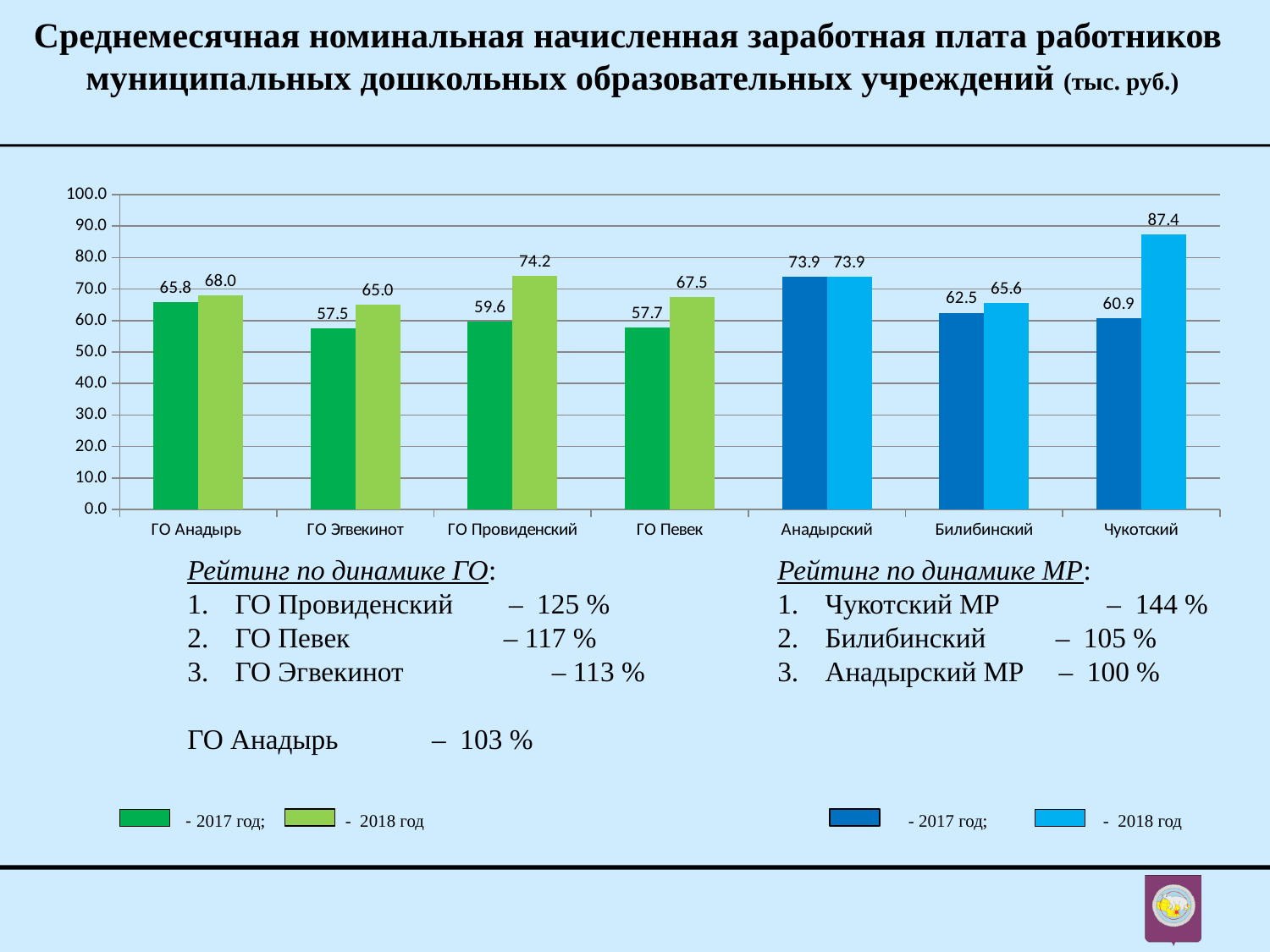
What was the 2017 value for ГО Провиденский? 59.6 What is the difference between the 2018 and 2017 values for Чукотский? 26.5 Which category has the lowest 2017 value? ГО Эгвекинот Which two years are compared in the chart legend? 2017 and 2018 What is the difference between the 2018 and 2017 values for ГО Провиденский? 14.6 What was the 2018 value for ГО Эгвекинот? 65.0 Which is larger, the 2017 value for Анадырский or the 2017 value for Билибинский? Анадырский Which category has the highest 2018 value? Чукотский What was the 2018 value for Чукотский? 87.4 Is the 2018 value for ГО Певек greater or less than 60.0? greater How many categories are shown on the x axis? 7 What kind of chart is shown on the slide? bar chart